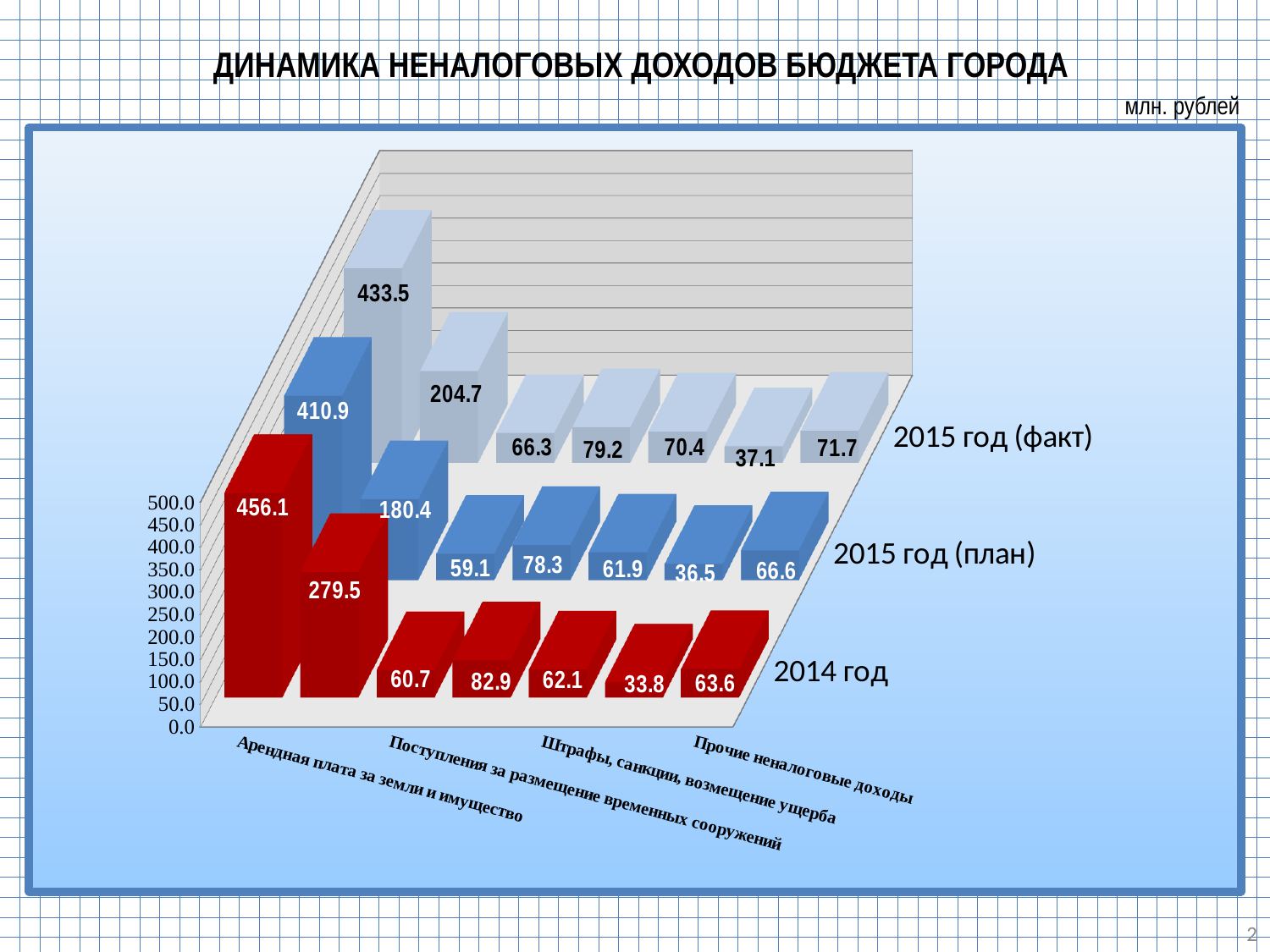
Which is larger for Прочие неналоговые доходы: the 2014 год value or the 2015 год (факт) value? 2015 год (факт) What is the value for Прочие неналоговые доходы in the 2014 год series? 63.6 What kind of chart is shown on the slide? Bar chart What is the value for Арендная плата за земли и имущество in the 2015 год (факт) series? 433.5 What is the difference between the 2014 год and 2015 год (факт) values for Арендная плата за земли и имущество? 22.6 What unit of measurement is indicated for the chart? млн. рублей What is the value for Арендная плата за земли и имущество in the 2014 год series? 456.1 What is the value for Прочие неналоговые доходы in the 2015 год (план) series? 66.6 What is the lowest value shown in the 2015 год (план) series? 36.5 How many bars are plotted in each series? 7 Which category has the highest value in the 2015 год (факт) series? Арендная плата за земли и имущество How many series are shown in the chart? 3